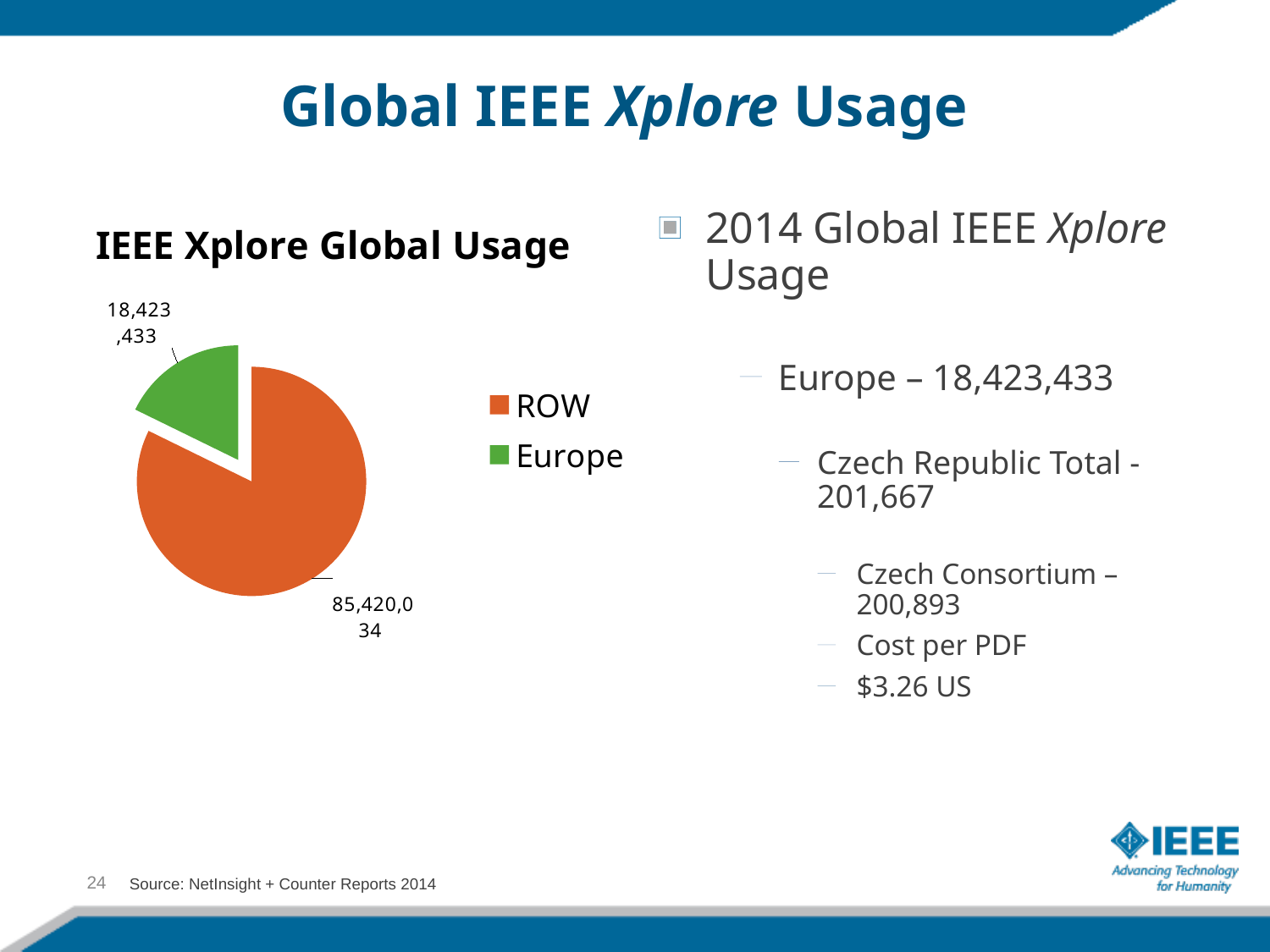
Which slice of the pie chart is the smallest? Europe What is the value shown for Europe in the IEEE Xplore Global Usage pie chart? 18,423,433 Which slice of the pie chart is the largest? ROW What kind of chart is shown on the slide? pie chart Which is larger in the pie chart, ROW or Europe? ROW What is the combined total of the ROW and Europe values in the pie chart? 103,843,467 What is the difference between the ROW value and the Europe value in the pie chart? 66,996,601 How many entries does the legend of the pie chart list? 2 What is the value shown for ROW in the IEEE Xplore Global Usage pie chart? 85,420,034 What colour is the Europe slice in the pie chart? green How many slices does the pie chart have? 2 What is the title of the pie chart? IEEE Xplore Global Usage